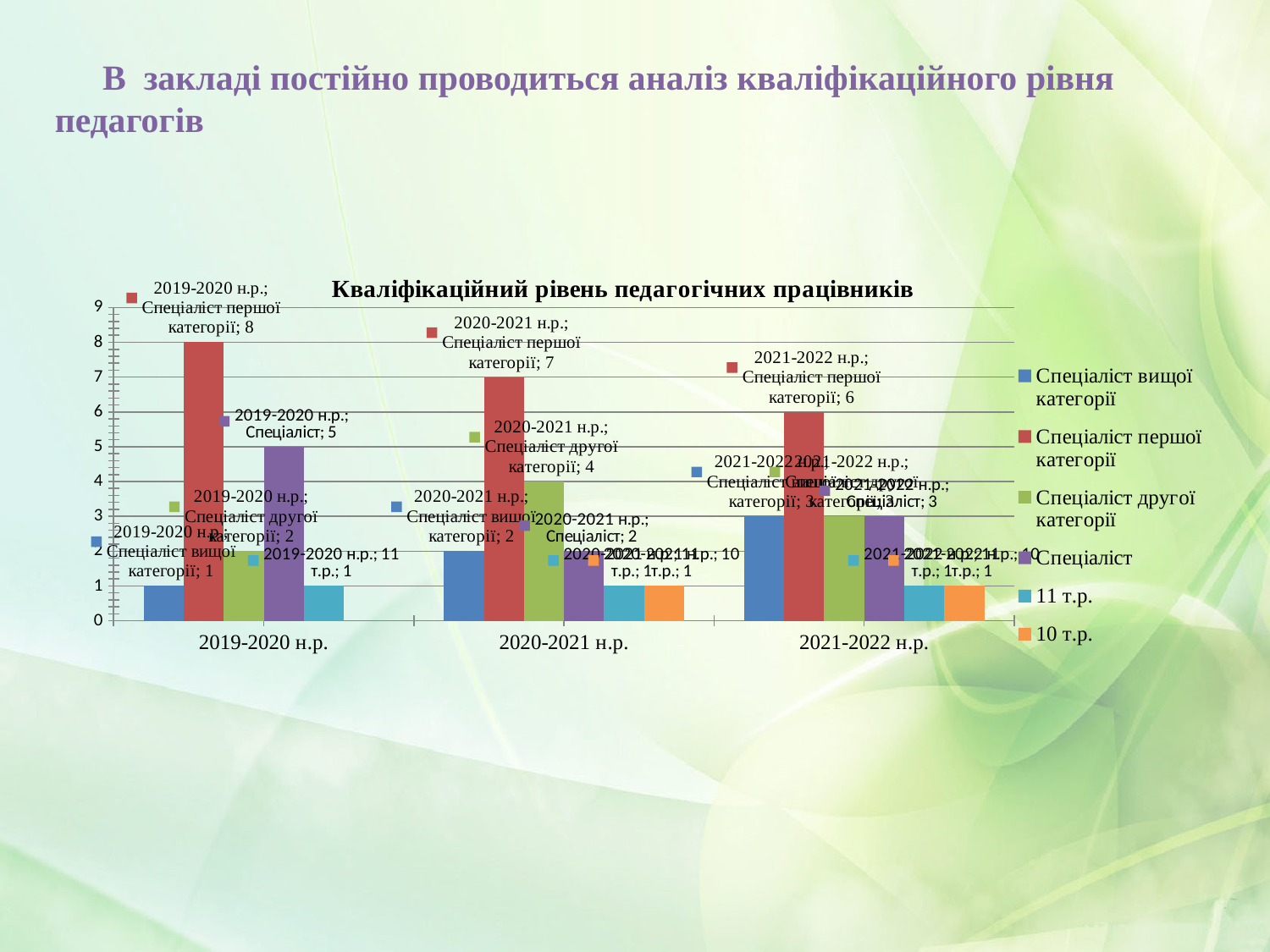
What is the title of the chart? Кваліфікаційний рівень педагогічних працівників What is the difference between Спеціаліст першої категорії in 2019-2020 н.р. and in 2021-2022 н.р.? 2 What is the value for Спеціаліст in 2019-2020 н.р.? 5 What kind of chart is shown on the slide? bar chart What is the value for Спеціаліст другої категорії in 2020-2021 н.р.? 4 Which series has the highest value in 2020-2021 н.р.? Спеціаліст першої категорії Does the value for Спеціаліст першої категорії rise or fall from 2019-2020 н.р. to 2021-2022 н.р.? fall How many series does the legend list? 6 How many academic years (categories) are shown on the x axis? 3 What is the value for Спеціаліст першої категорії in 2019-2020 н.р.? 8 What is the value for Спеціаліст вищої категорії in 2021-2022 н.р.? 3 Which is larger: Спеціаліст другої категорії in 2020-2021 н.р. or Спеціаліст in 2020-2021 н.р.? Спеціаліст другої категорії